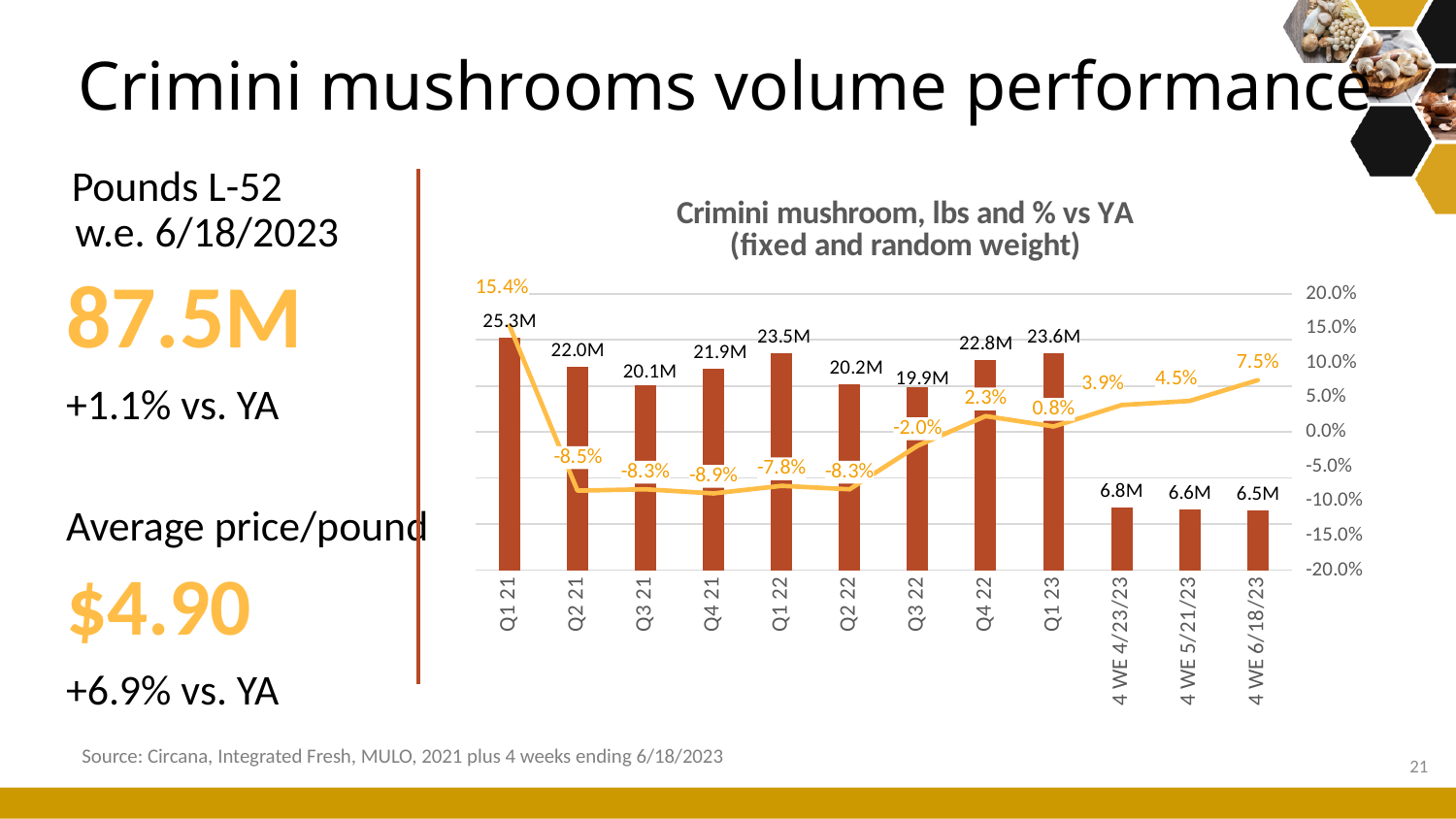
Which category has the lowest % vs YA value? Q4 21 What is the difference in pounds between Q1 23 and Q4 22? 0.7M What is the volume in pounds for Q1 21? 25.3M What is the title of the chart? Crimini mushroom, lbs and % vs YA (fixed and random weight) Does the % vs YA line rise or fall from Q3 22 to 4 WE 6/18/23? Rise What kind of chart is used to show the pounds values? Bar chart What is the % vs YA value for 4 WE 5/21/23? 4.5% Which has the larger volume in pounds, Q1 22 or Q2 22? Q1 22 How many categories are shown on the x axis? 12 What is the volume in pounds for the 4 WE 6/18/23 period? 6.5M What is the % vs YA value for Q3 22? -2.0% Which category has the highest volume in pounds? Q1 21